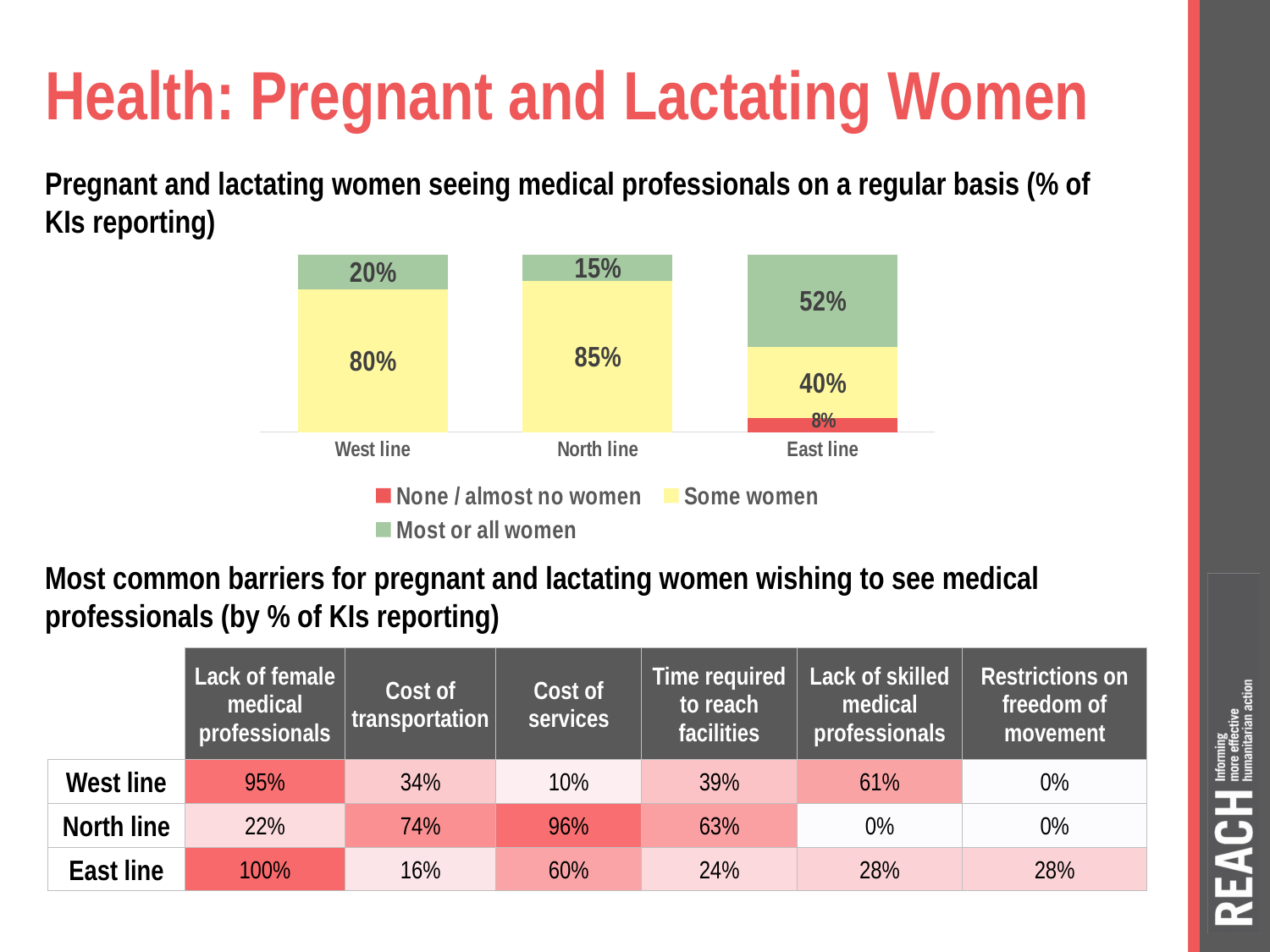
How many series does the chart legend list? 3 Which line has the highest value for "Some women"? North line What type of chart is used to show pregnant and lactating women seeing medical professionals? Stacked bar chart What percentage of KIs reported "None / almost no women" for East line? 8% What percentage of KIs reported "Most or all women" for East line? 52% Which is larger: the "Most or all women" value for East line or for West line? East line What percentage of KIs reported "Most or all women" for North line? 15% What percentage of KIs reported "Some women" for West line? 80% Which line has the lowest value for "Most or all women"? North line How many lines (categories) are shown on the x axis of the chart? 3 What is the difference between the "Some women" values for North line and West line? 5% What is the total of the stacked bar for East line? 100%